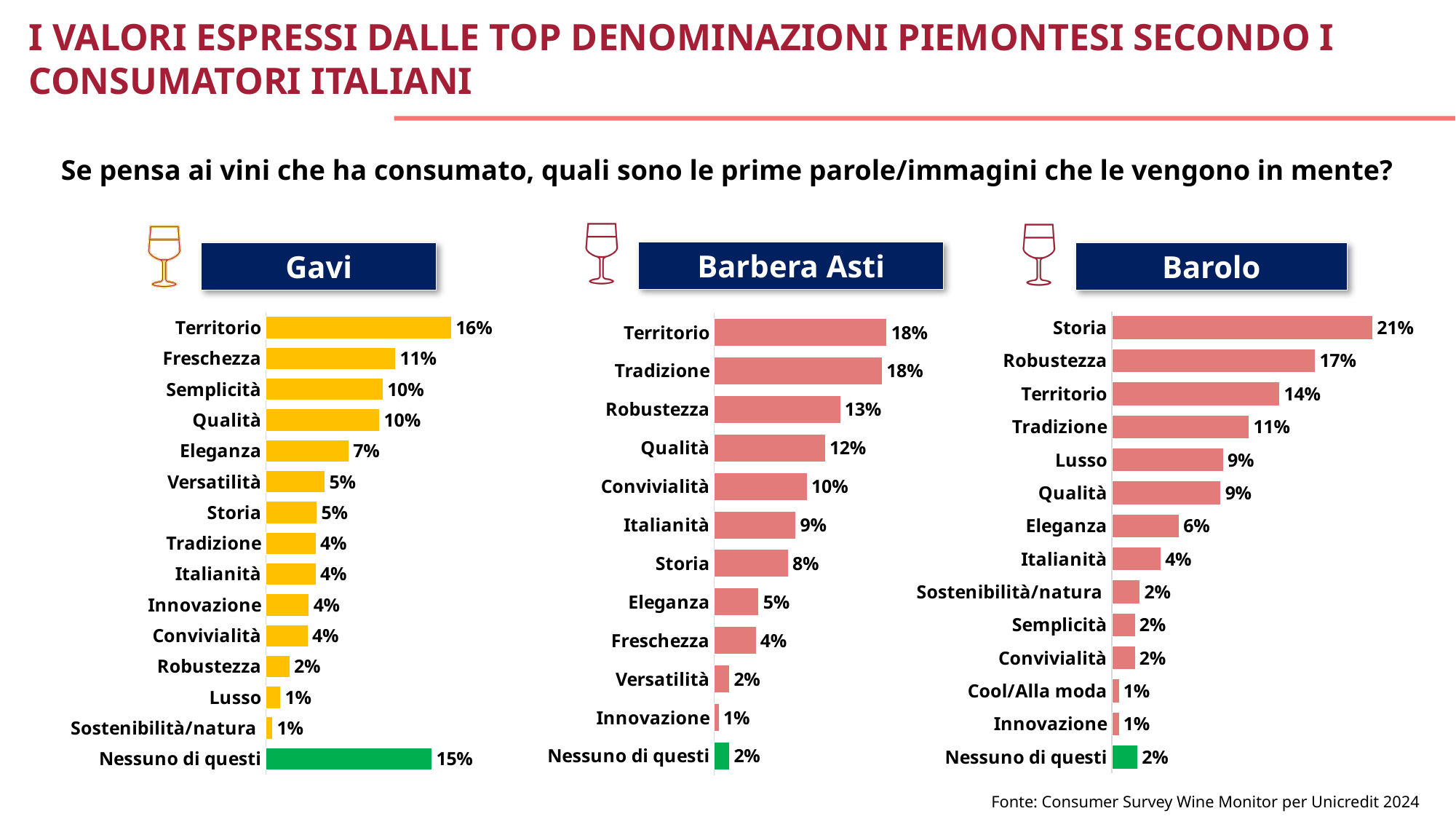
In the Barbera Asti chart, which category has the lowest value? Innovazione In the Barolo chart, what is the difference between Storia and Robustezza? 4% In the Barolo chart, which category has the highest value? Storia In the Gavi chart, which category has the highest value? Territorio In the Gavi chart, what is the difference between Territorio and Nessuno di questi? 1% In the Barbera Asti chart, what percentage is shown for Robustezza? 13% What kind of chart is the Barolo chart? Bar chart In the Gavi chart, what colour is the bar for Nessuno di questi? Green How many categories are shown in the Gavi chart? 15 In the Gavi chart, what percentage is shown for Territorio? 16% In the Barbera Asti chart, which is larger, Qualità or Convivialità? Qualità In the Barolo chart, what percentage is shown for Lusso? 9%